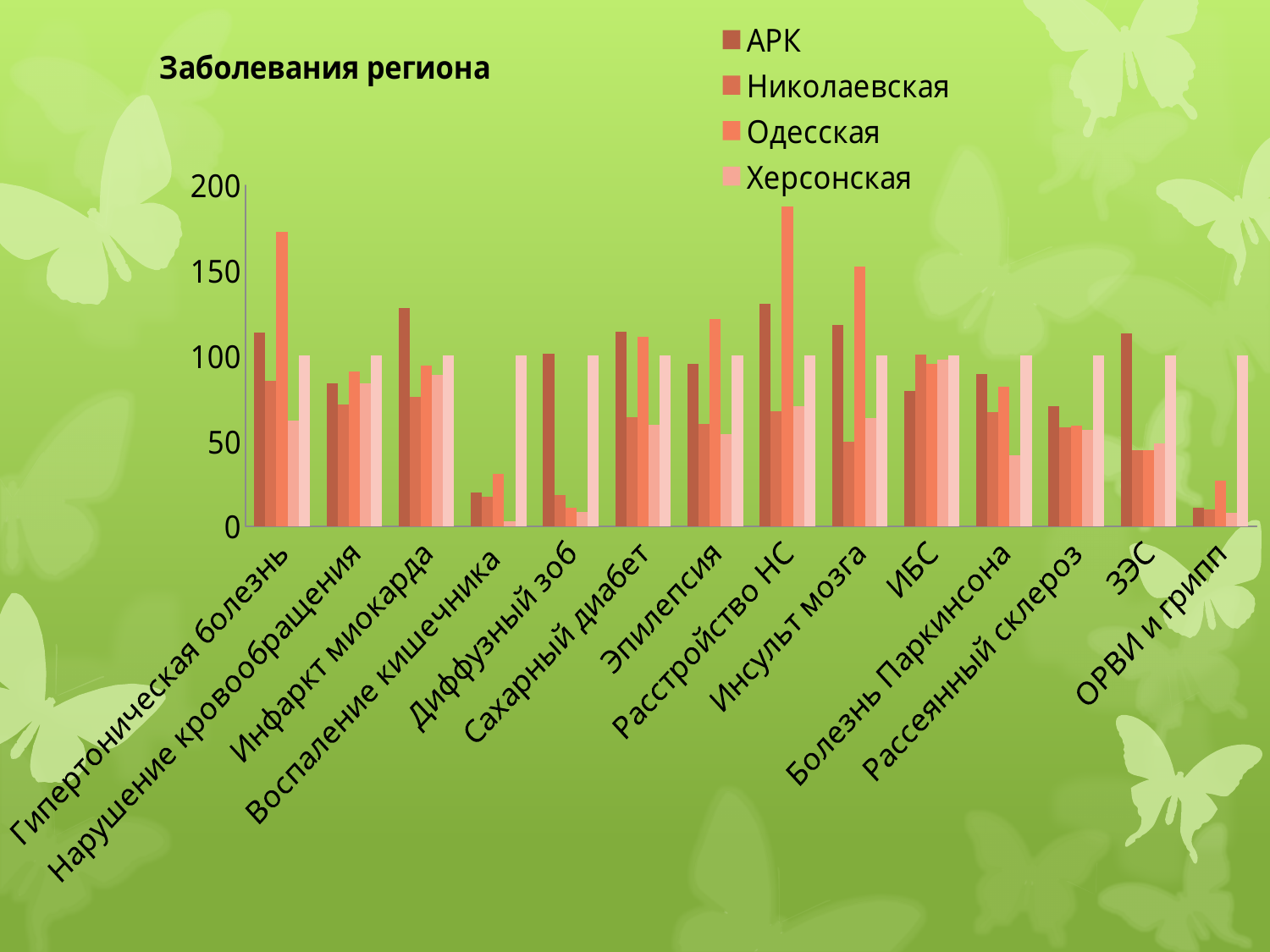
For Эпилепсия, which is larger: the value for Николаевская or the value for Одесская? Одесская Is the value for АРК for Инфаркт миокарда greater or less than 100? greater For Инфаркт миокарда, which is larger: the value for АРК or the value for Одесская? АРК Is the value for Одесская for Расстройство НС greater or less than 150? greater For which category is the Одесская value the highest? Расстройство НС How many disease categories are shown on the x axis? 14 What is the title of the chart? Заболевания региона What kind of chart is shown on the slide? bar chart Is the value for АРК for ОРВИ и грипп greater or less than 50? less How many series does the legend list? 4 Which series has the highest value for Расстройство НС? Одесская